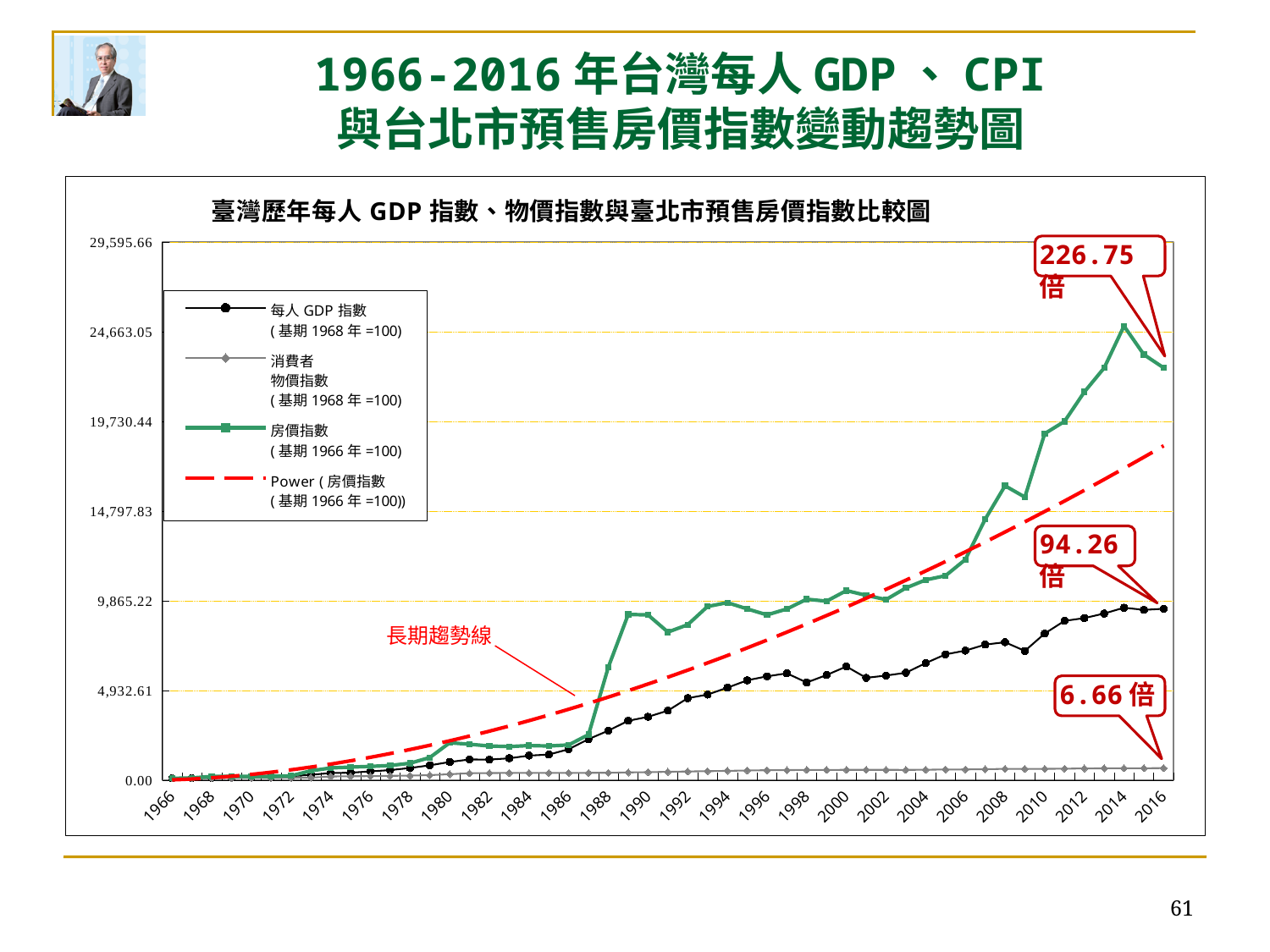
What multiple (倍) is annotated at the end of the 房價指數 line? 226.75 倍 In 2016, which is higher: 房價指數 or 每人 GDP 指數? 房價指數 What label is attached to the red dashed line in the chart? 長期趨勢線 What multiple (倍) is annotated at the end of the 消費者物價指數 line? 6.66 倍 Which series reaches the highest value on the chart? 房價指數 Is the value of 房價指數 in 2016 greater or less than 19,730.44? greater Does the 房價指數 line rise or fall between 2014 and 2016? fall What multiple (倍) is annotated at the end of the 每人 GDP 指數 line? 94.26 倍 How many series does the chart's legend list? 4 Which series stays lowest across the whole period? 消費者物價指數 What kind of chart is shown on the slide? line chart What is the title printed inside the chart area? 臺灣歷年每人 GDP 指數、物價指數與臺北市預售房價指數比較圖